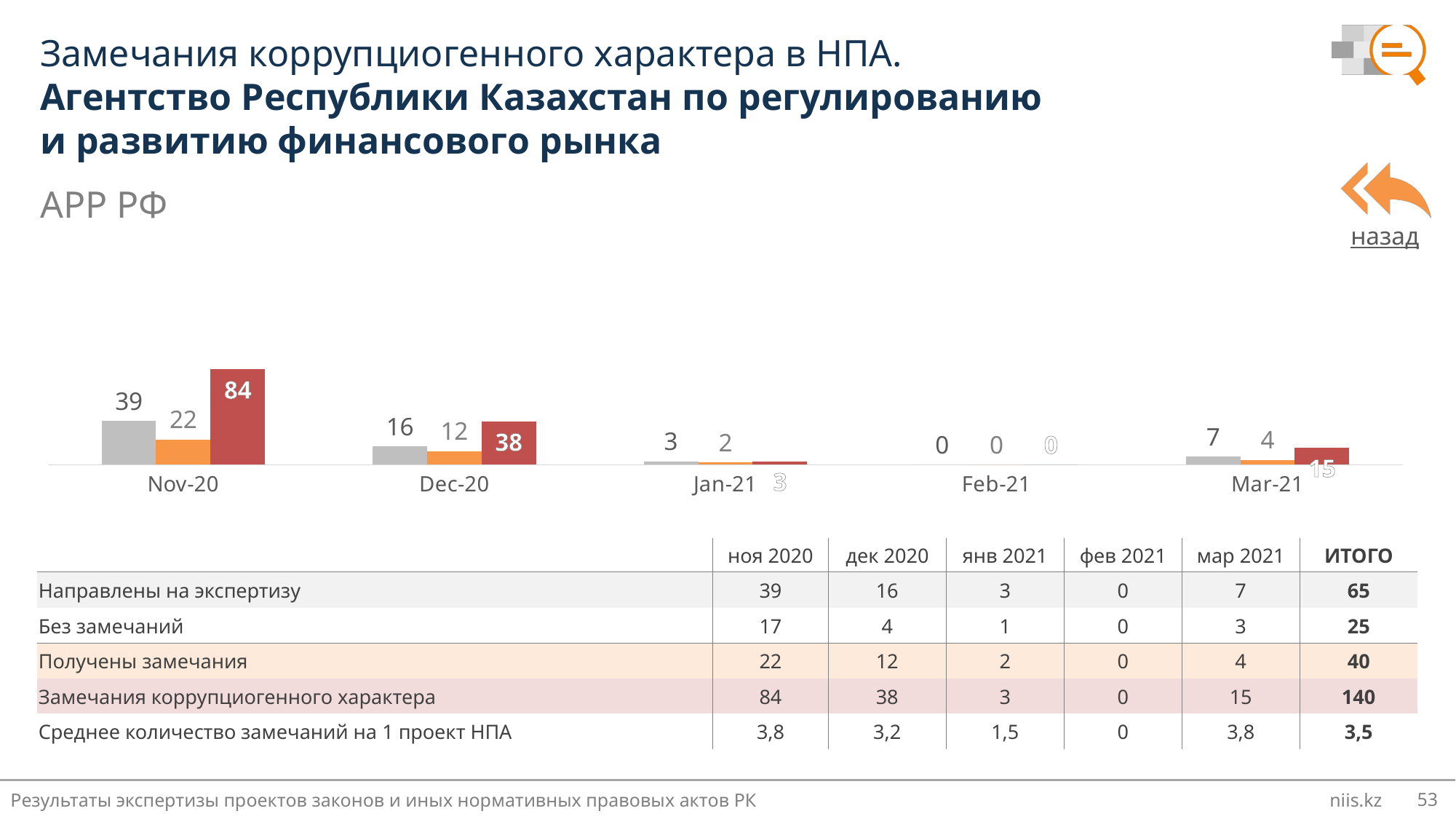
What type of chart is shown on the slide? bar chart Which month has the lowest grey bar? Feb-21 What is the difference between the red bar values for Nov-20 and Dec-20? 46 What is the value of the orange bar for Mar-21? 4 What is the value of the grey bar for Dec-20? 16 What is the value of the red bar for Nov-20? 84 Do the grey bar values rise or fall from Nov-20 to Feb-21? fall What is the difference between the grey bar and the orange bar for Dec-20? 4 How many months (categories) are shown on the x axis of the chart? 5 Which is larger for Nov-20: the grey bar or the orange bar? the grey bar What is the value of the red bar for Mar-21? 15 Which month has the highest red bar? Nov-20